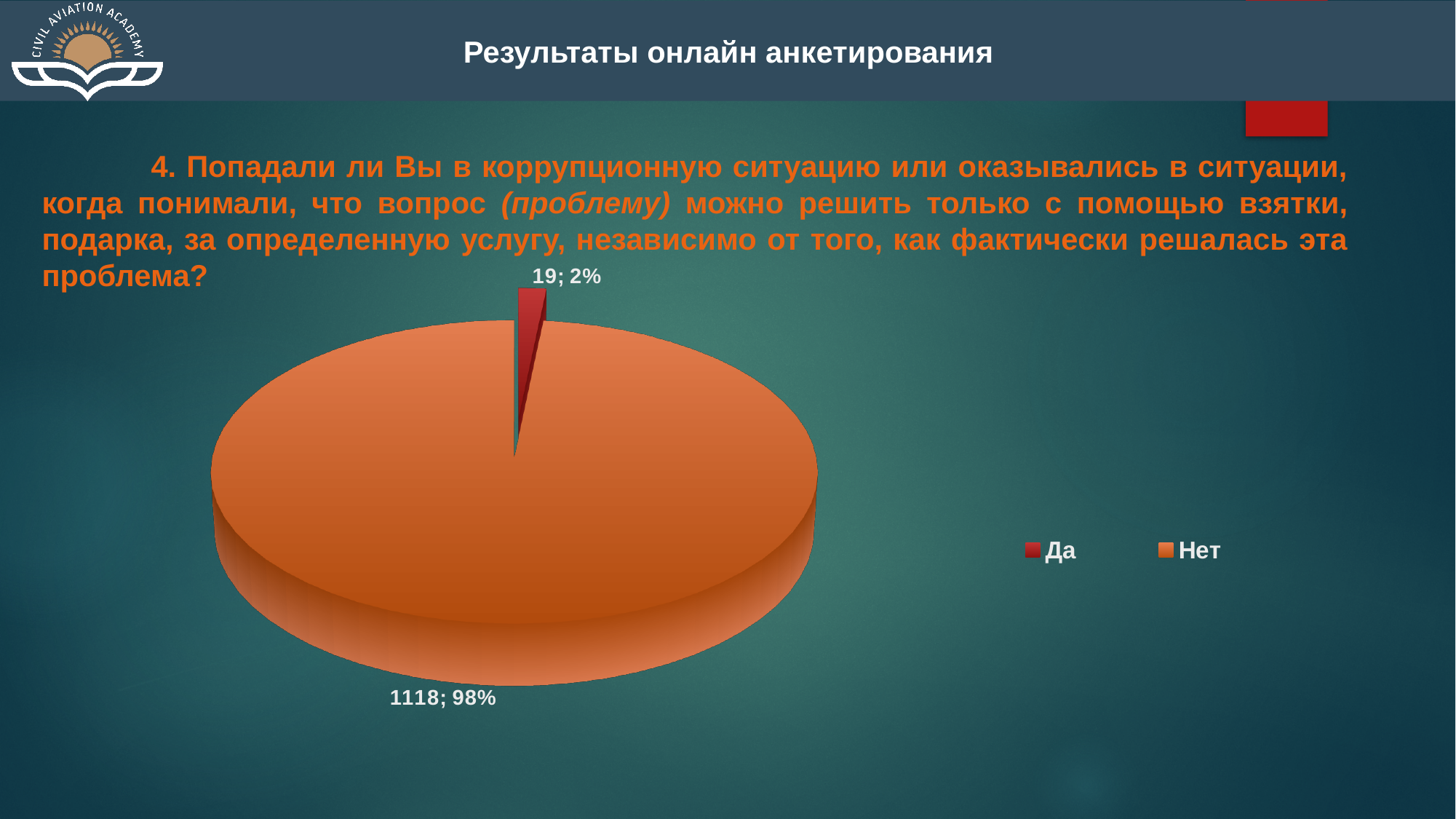
How many entries does the legend list? 2 What percentage of respondents answered "Нет"? 98% How many slices does the pie chart have? 2 How many respondents answered "Нет"? 1118 What colour is the "Да" slice in the pie chart? red Which answer has the largest slice of the pie? Нет Which answer has the smallest slice of the pie? Да What percentage of respondents answered "Да"? 2% How many respondents answered "Да"? 19 What kind of chart is shown on the slide? pie chart Which answer received more responses, "Да" or "Нет"? Нет What is the difference between the number of "Нет" and "Да" responses? 1099